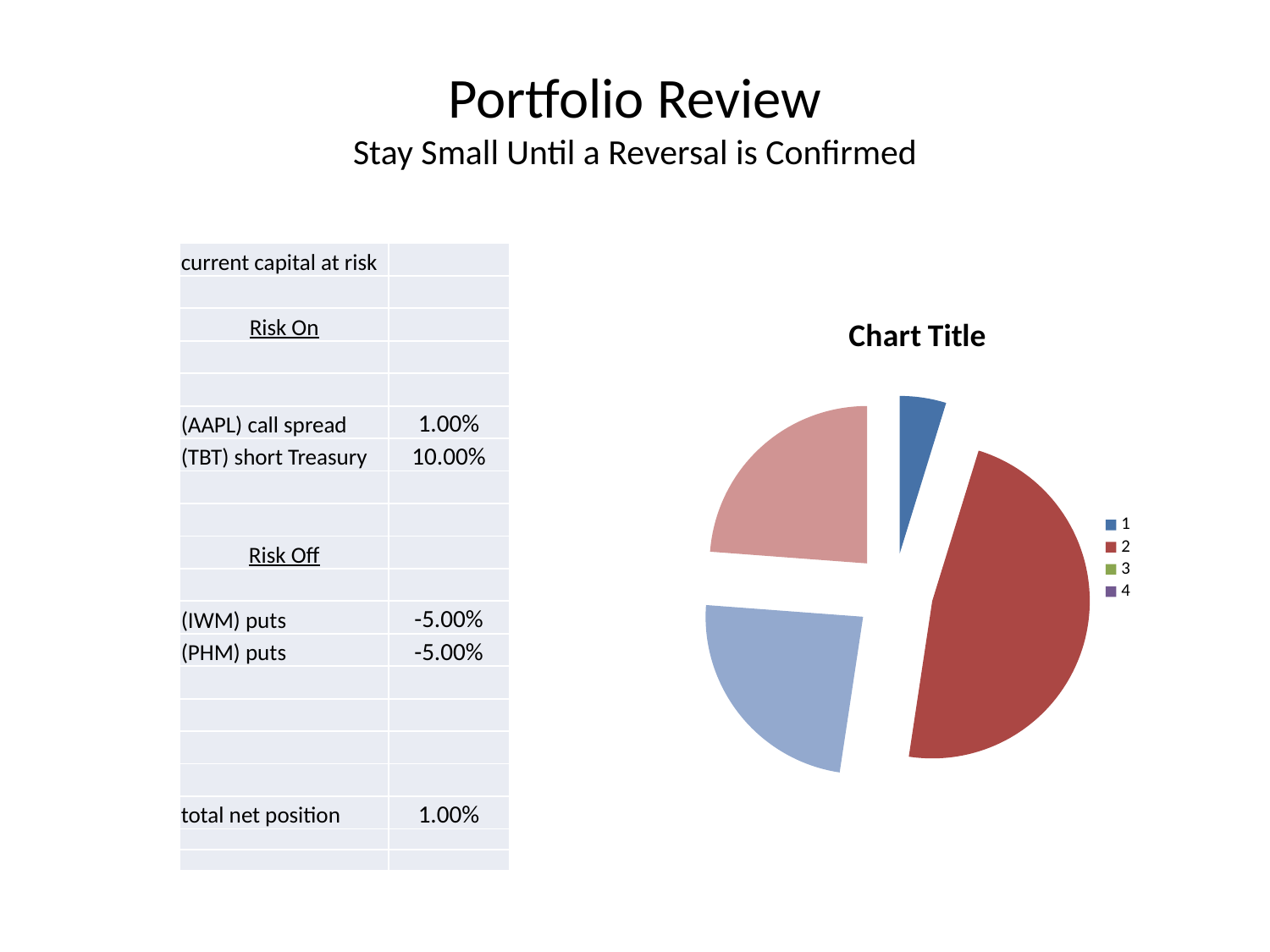
In the pie chart, which is larger, slice 2 or slice 4? 2 What kind of chart is shown on the slide? pie chart Which slice of the pie chart is the smallest? 1 What is the title of the chart on the slide? Chart Title In the pie chart, which is larger, slice 1 or slice 3? 3 How many entries does the chart's legend list? 4 In the pie chart, which is larger, slice 1 or slice 2? 2 How many slices does the pie chart have? 4 What are the labels listed in the chart's legend? 1, 2, 3, 4 Which slice of the pie chart is the largest? 2